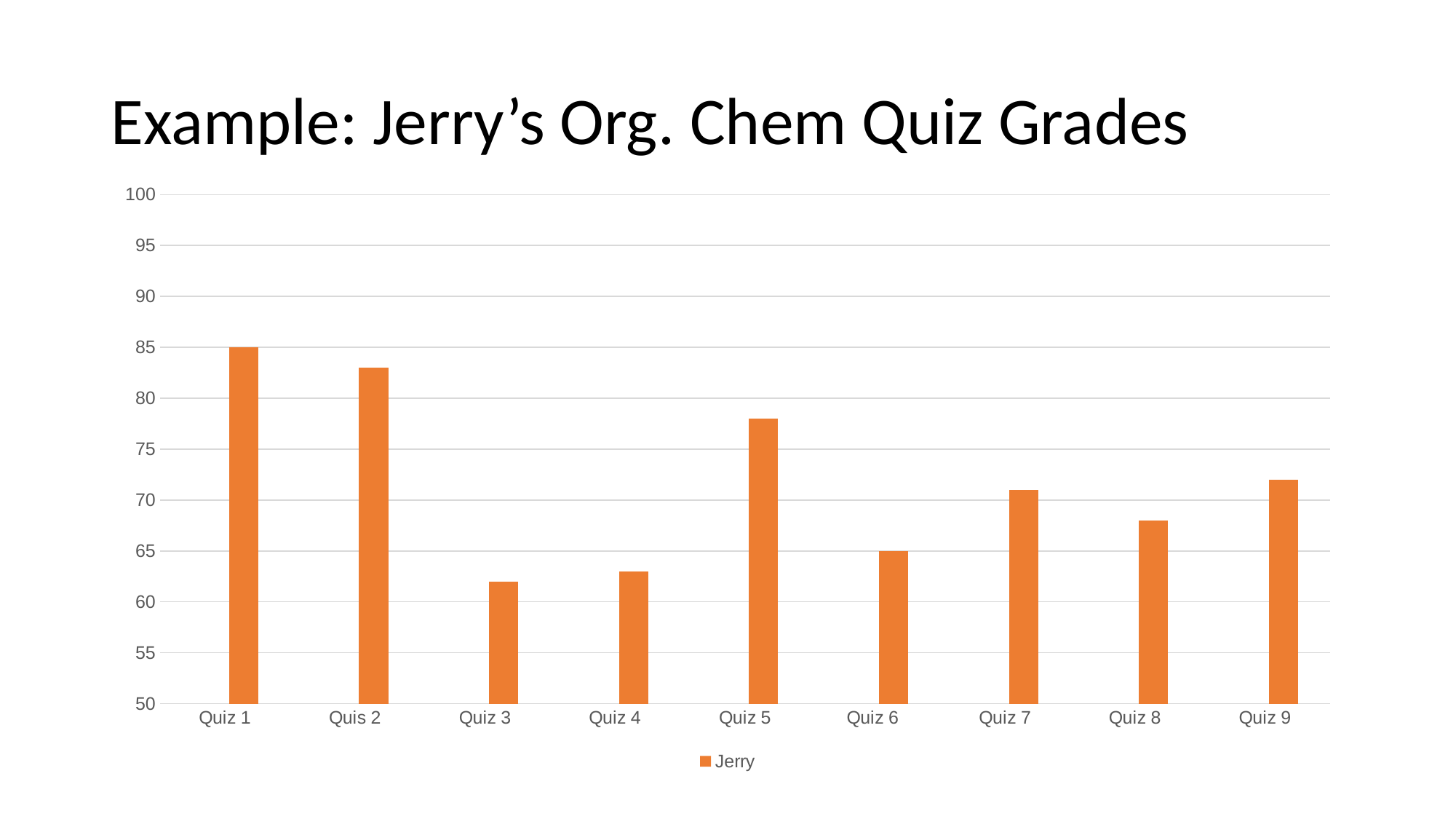
Is the value for Quiz 8 greater or less than 70? less How many series does the legend list? 1 What is Jerry's grade for Quiz 6? 65 What kind of chart is shown on the slide? Bar chart Which quiz has the highest grade? Quiz 1 Do the grades rise or fall from Quiz 1 to Quiz 3? fall Is the value for Quiz 5 greater or less than 75? greater Which is larger, the grade for Quiz 5 or the grade for Quiz 9? Quiz 5 What is Jerry's grade for Quiz 1? 85 What is the name of the series shown in the legend? Jerry How many quizzes are plotted on the chart? 9 Is the value for Quiz 3 greater or less than 65? less